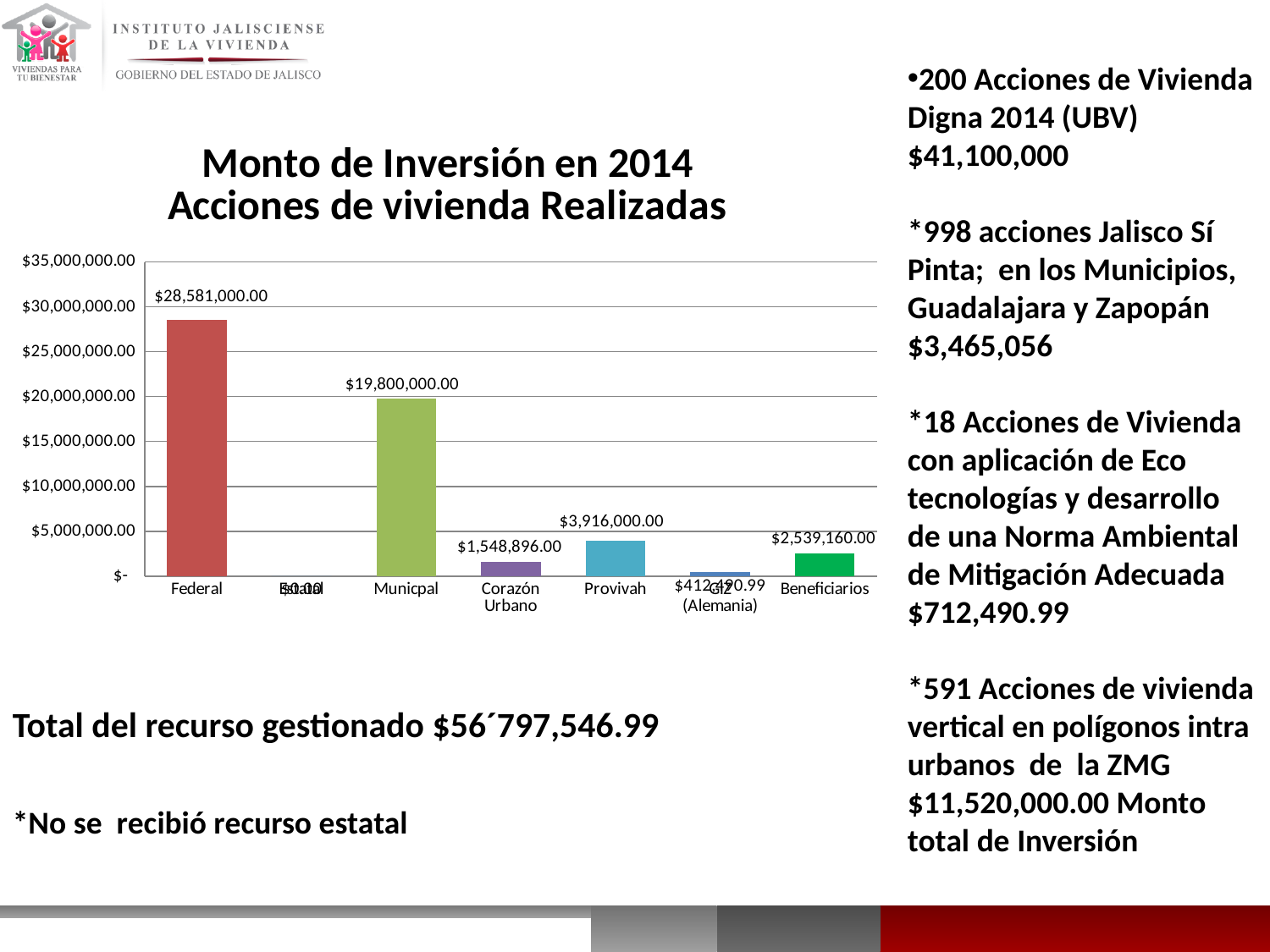
What is the value for Municpal in the chart? $19,800,000.00 What is the value for Corazón Urbano in the chart? $1,548,896.00 What is the difference between the values for Provivah and Corazón Urbano? $2,367,104.00 What kind of chart is shown on the slide? bar chart Which category has the highest value in the chart? Federal What is the value for Provivah in the chart? $3,916,000.00 Which is larger, the value for Provivah or the value for Beneficiarios? Provivah Is the value for Municpal greater or less than $15,000,000.00? greater How many categories are shown on the x axis of the chart? 7 What is the difference between the values for Federal and Municpal? $8,781,000.00 What is the value for Beneficiarios in the chart? $2,539,160.00 What is the value for Federal in the chart? $28,581,000.00